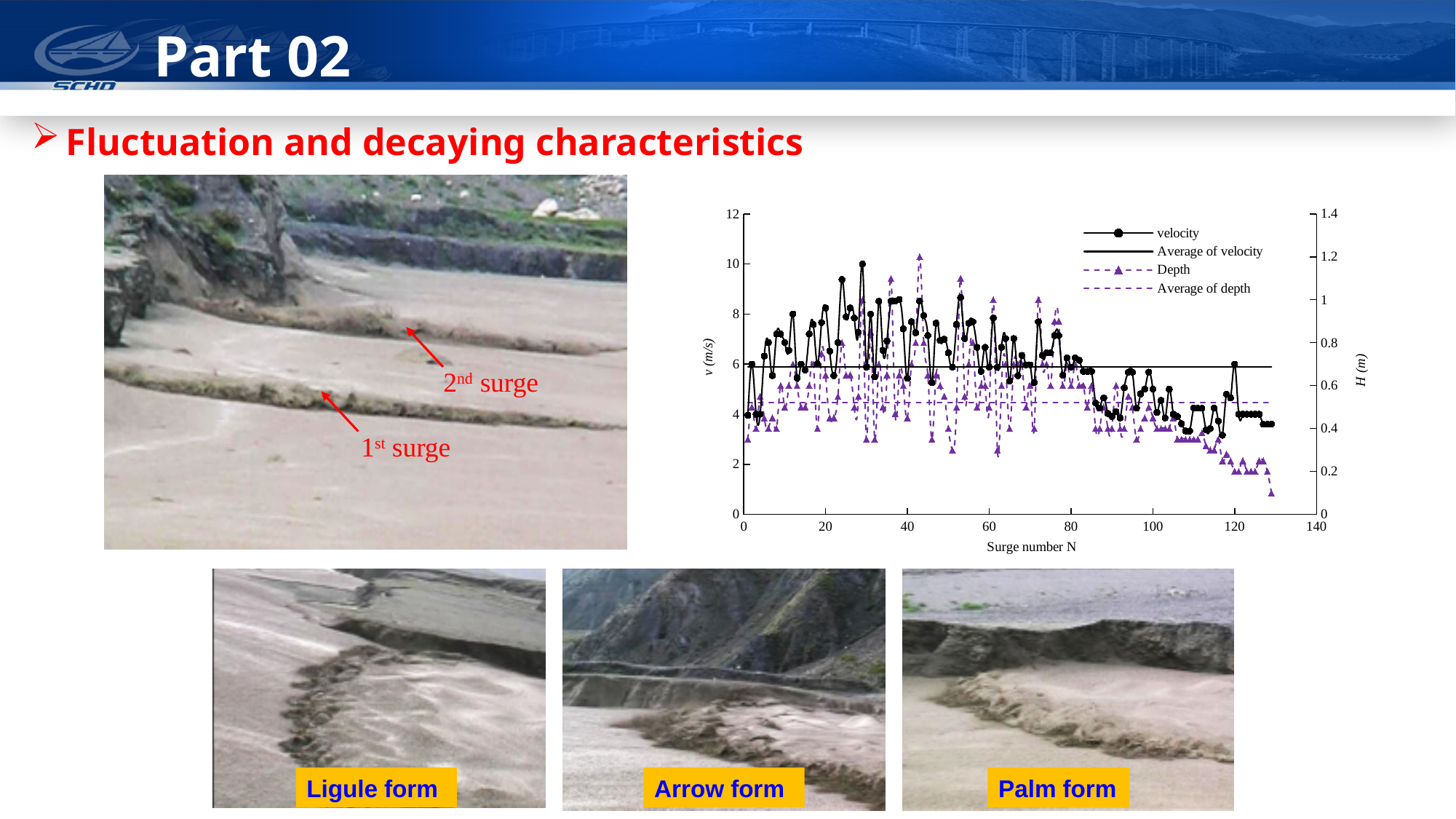
Which series has the higher value at surge number 120: velocity (left axis) or depth (right axis), relative to their own axes' maximum ticks? velocity What is the label of the x axis of the chart? Surge number N Is the highest depth value plotted on the chart greater or less than 1 m? greater How many series does the chart's legend list? 4 Is the velocity value at the last surge number (around 130) greater or less than 6 m/s? less Overall, does the velocity rise or fall as the surge number increases along the x axis? fall Is the average of depth line on the chart greater or less than 0.6 m on the right axis? less What is the maximum tick value shown on the x axis of the chart? 140 What kind of chart is shown on the slide? line chart What is the label of the left y axis of the chart? v (m/s)